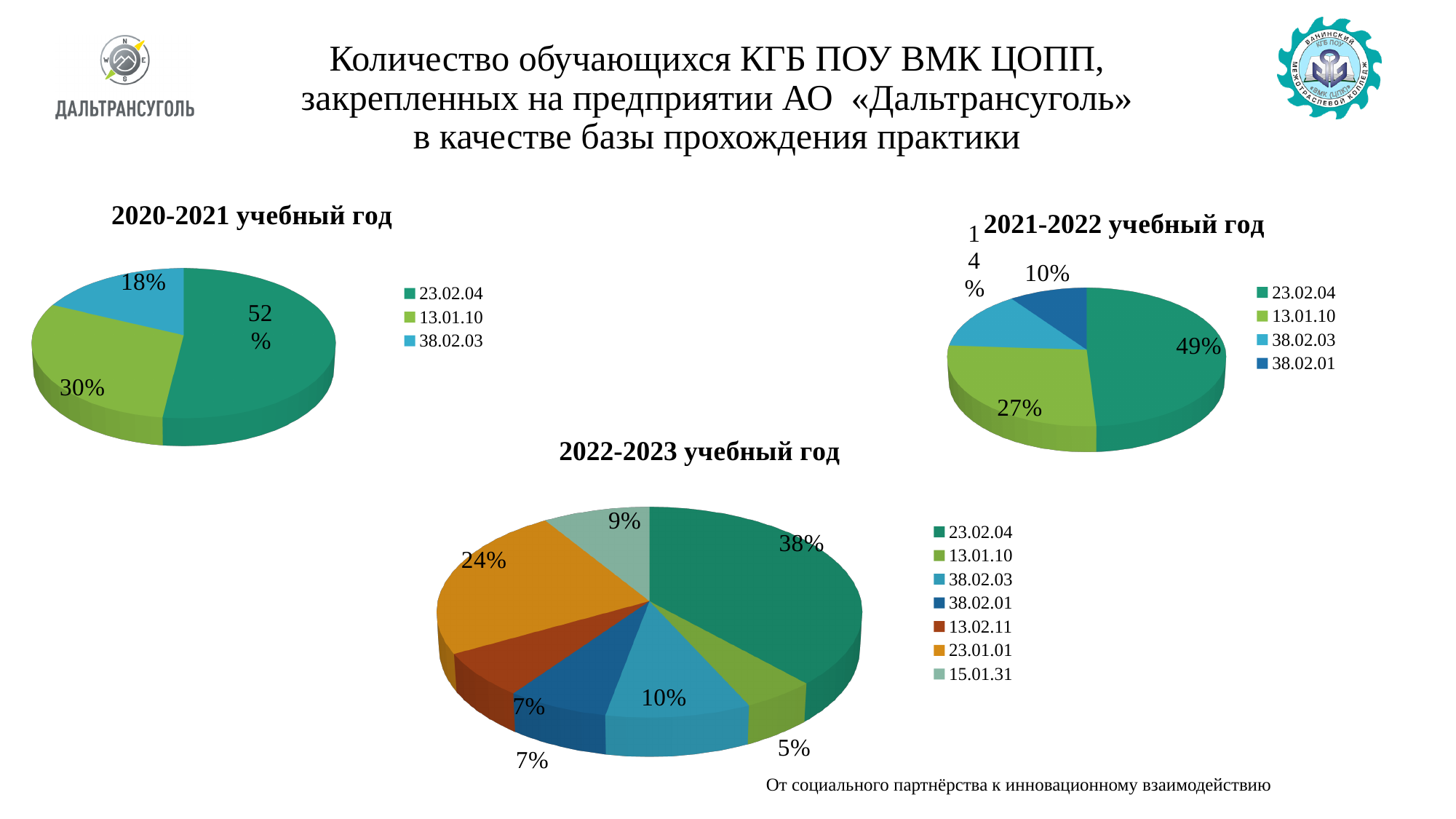
In the 2021-2022 учебный год chart, what share does 38.02.01 have? 10% In the 2020-2021 учебный год chart, what share does 23.02.04 have? 52% In the 2020-2021 учебный год chart, what share does 38.02.03 have? 18% In the 2022-2023 учебный год chart, which is larger, the share of 38.02.03 or the share of 13.01.10? 38.02.03 In the 2022-2023 учебный год chart, how many categories does the legend list? 7 In the 2020-2021 учебный год chart, which category has the smallest slice? 38.02.03 In the 2022-2023 учебный год chart, which category has the largest slice? 23.02.04 What type of chart is the 2022-2023 учебный год chart? Pie chart In the 2021-2022 учебный год chart, how many categories does the legend list? 4 In the 2020-2021 учебный год chart, what is the difference between the shares of 23.02.04 and 13.01.10? 22%